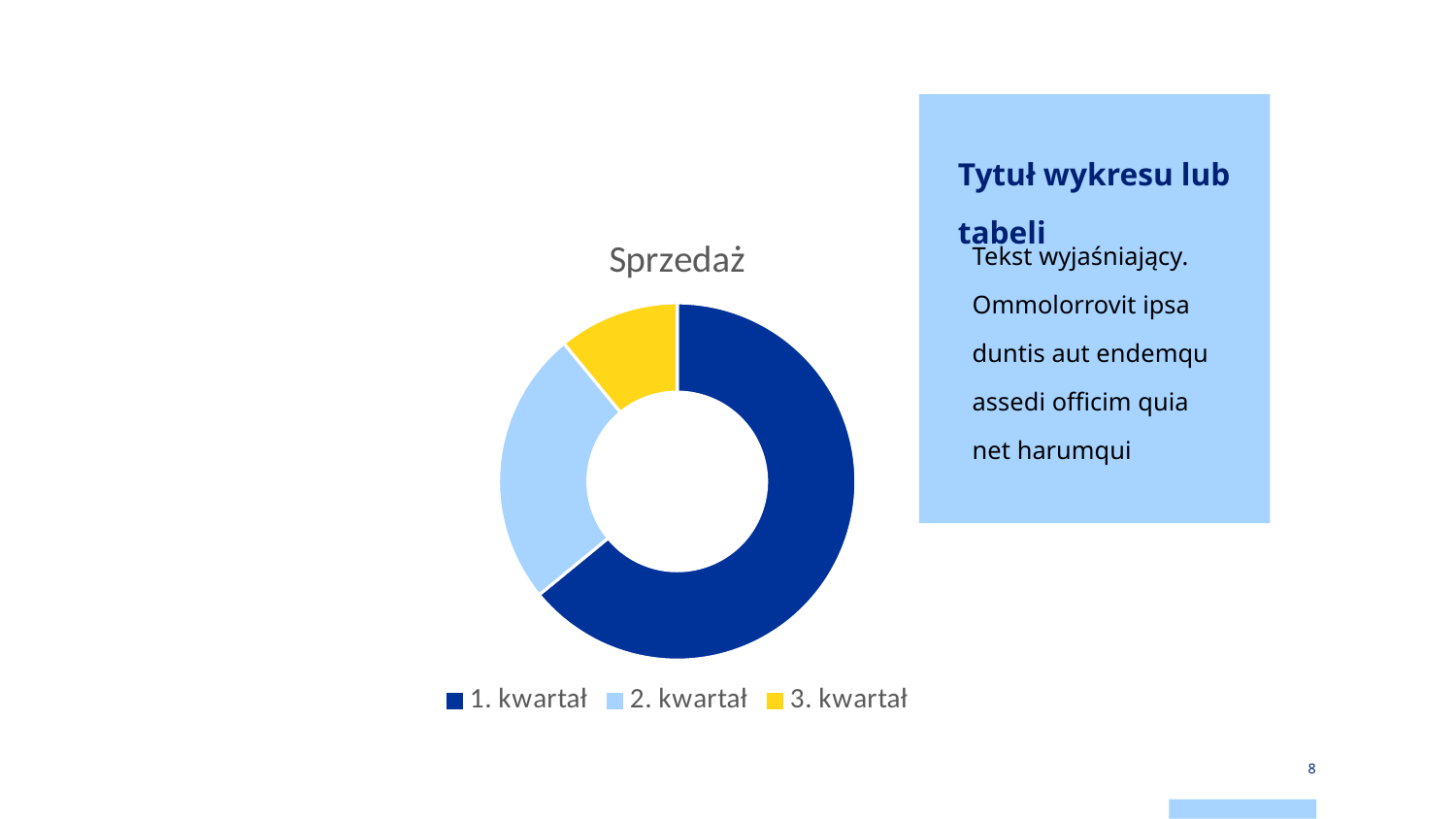
What is the title of the chart? Sprzedaż What kind of chart is shown on the slide? doughnut chart Which is larger, the share for 1. kwartał or the share for 2. kwartał? 1. kwartał Which colour represents 3. kwartał in the chart? yellow How many categories does the chart show? 3 Does 1. kwartał account for more or less than half of the chart? more Which category has the smallest share of the chart? 3. kwartał How many entries does the chart legend list? 3 Which is larger, the share for 2. kwartał or the share for 3. kwartał? 2. kwartał Which category has the largest share of the chart? 1. kwartał